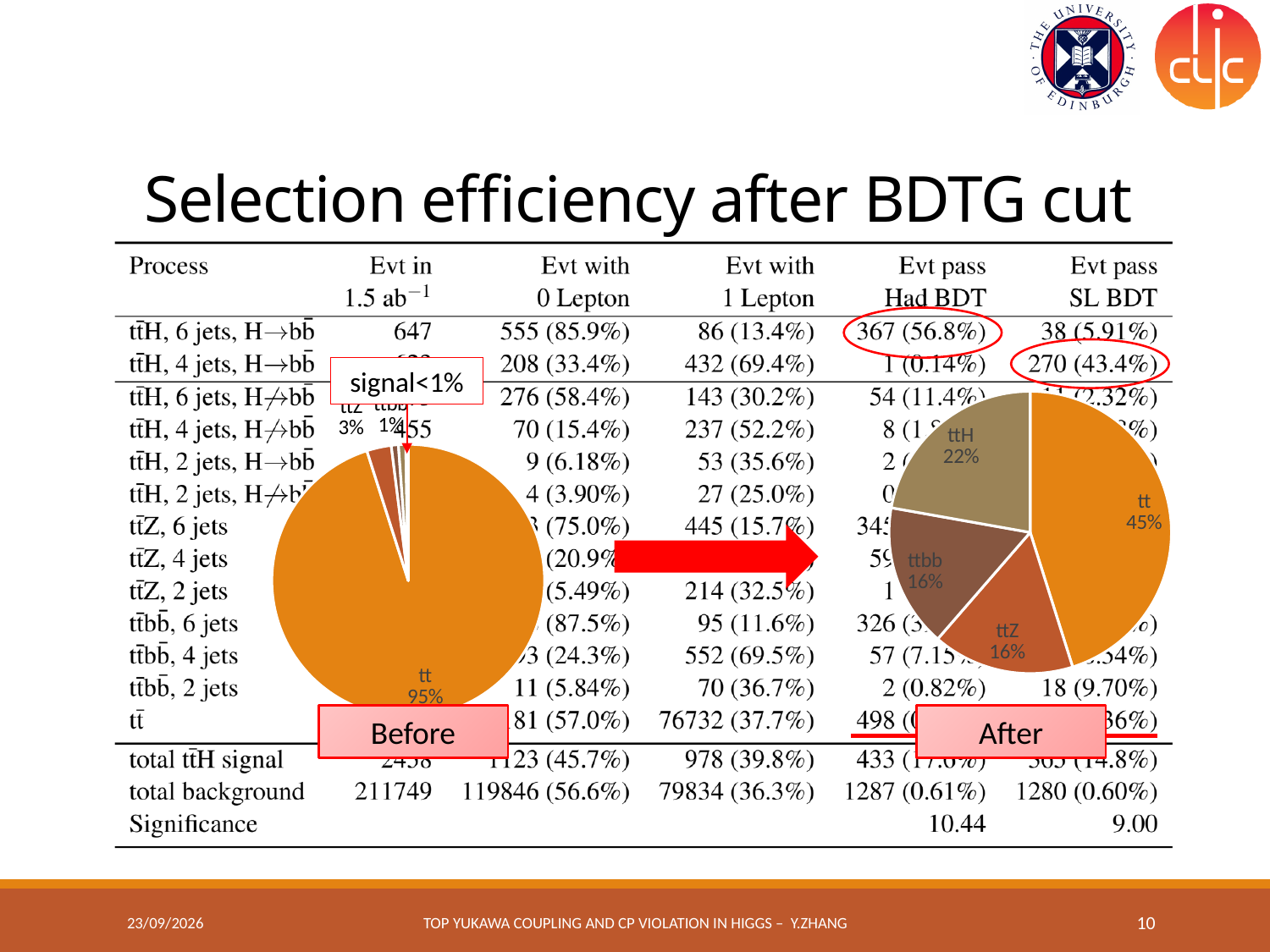
In the 'After' pie chart, which category has the second largest share? ttH In the 'After' pie chart, what share does ttH have? 22% In the 'After' pie chart, what is the difference between the tt share and the ttH share? 23% In the 'After' pie chart, which category has the largest share? tt In the 'Before' pie chart, what share does ttZ have? 3% According to the annotation on the 'Before' pie chart, what is the signal share? signal<1% In the 'Before' pie chart, which labelled category has the largest share? tt In the 'Before' pie chart, what share does ttbb have? 1% What kind of chart is used for the 'Before' and 'After' figures? pie chart